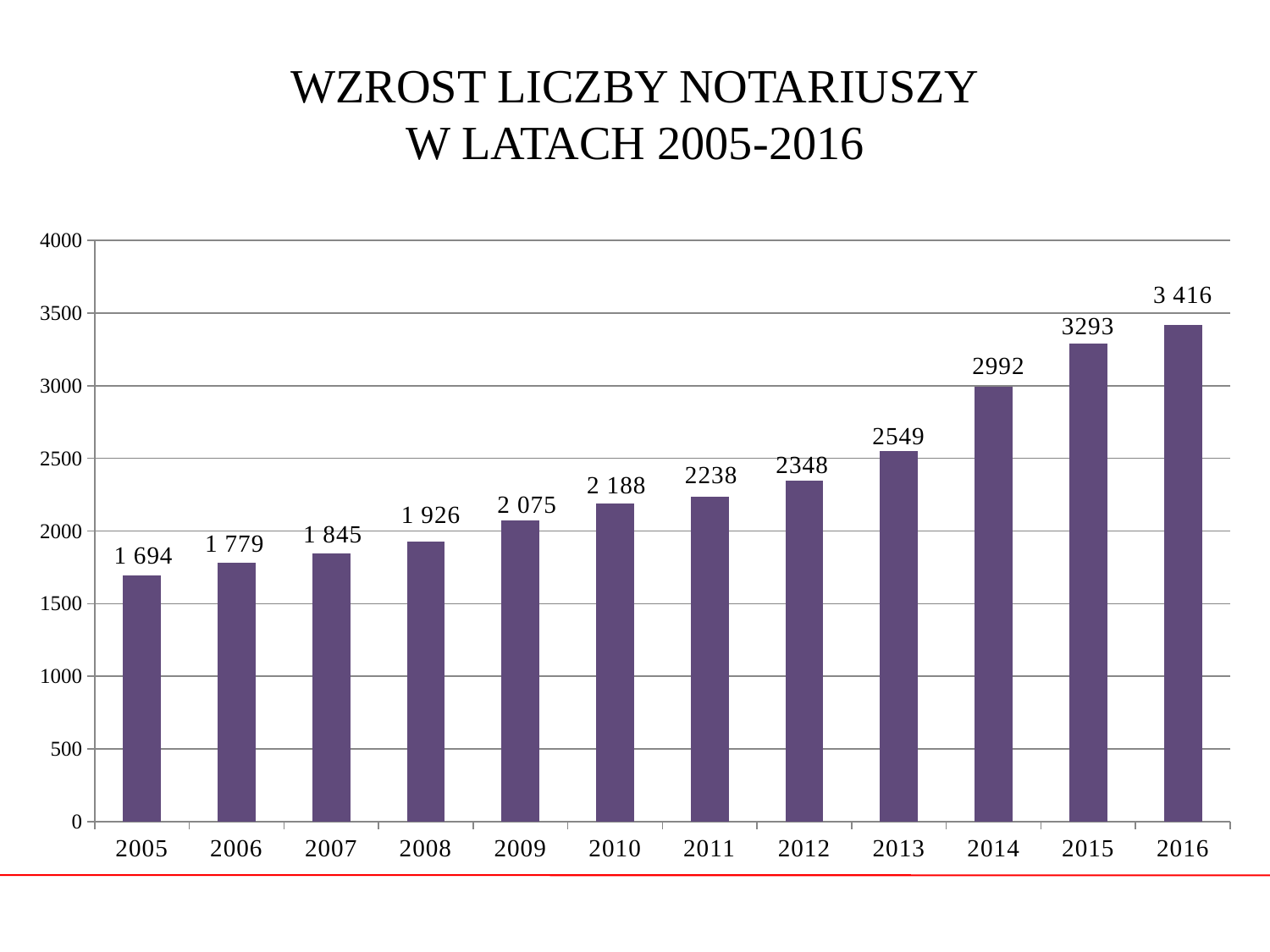
Which is larger, the value for 2008 or the value for 2011? 2011 Do the values rise or fall from 2005 to 2016? rise Which year has the highest value? 2016 What kind of chart is shown on the slide? bar chart What is the value for 2014? 2992 Is the value for 2014 greater or less than 2500? greater What is the difference between the values for 2016 and 2015? 123 How many years are shown on the x axis? 12 Which year has the lowest value? 2005 What is the value for 2010? 2 188 What is the value for 2005? 1 694 What is the difference between the values for 2013 and 2012? 201